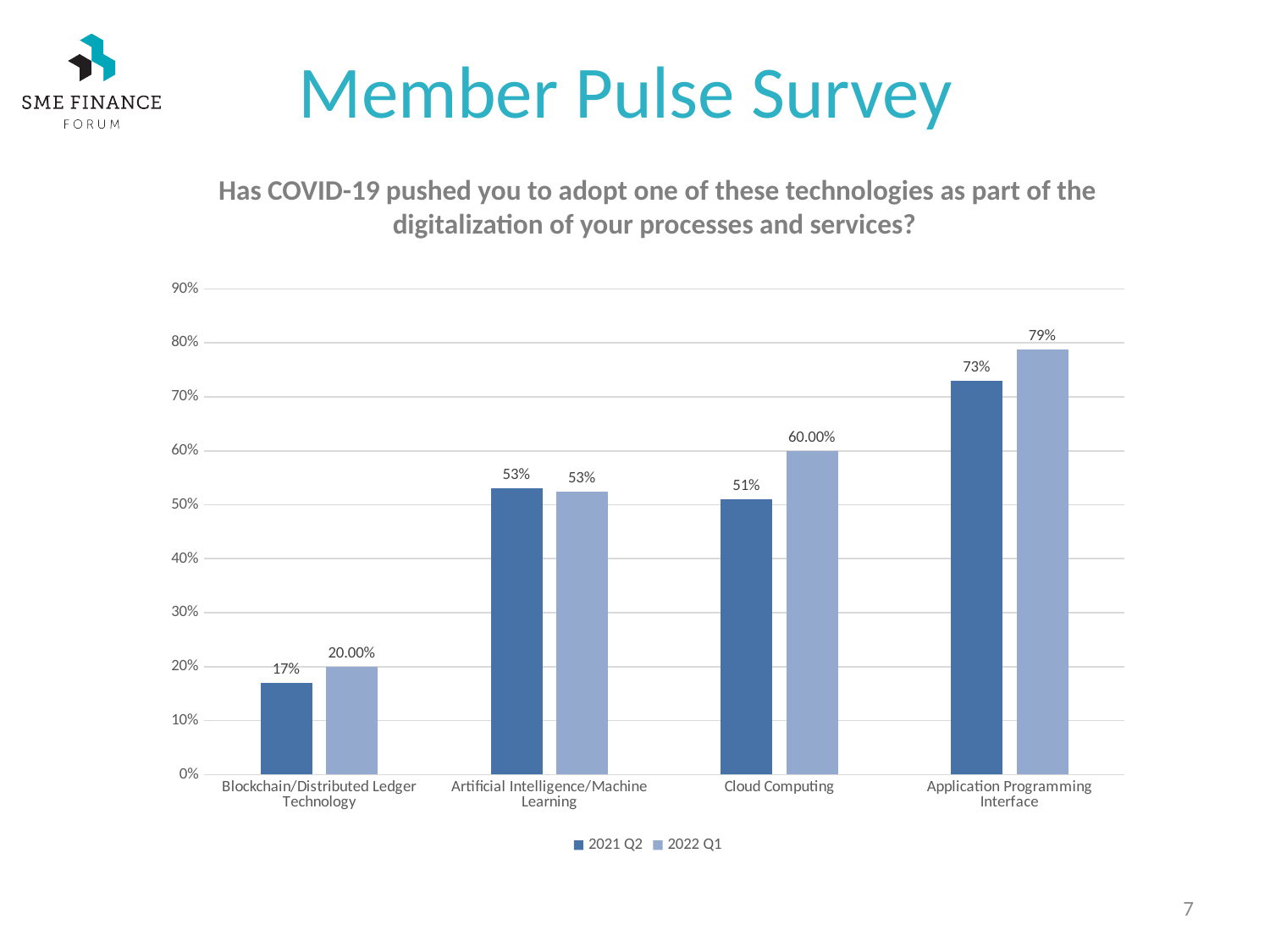
What is the value for Blockchain/Distributed Ledger Technology in the 2022 Q1 series? 20.00% Which is larger for Application Programming Interface: the 2021 Q2 value or the 2022 Q1 value? 2022 Q1 What is the difference between the 2022 Q1 and 2021 Q2 values for Cloud Computing? 9% How many series does the legend list? 2 Which category has the highest value in the 2022 Q1 series? Application Programming Interface What is the value for Cloud Computing in the 2022 Q1 series? 60.00% What kind of chart is shown on the slide? Bar chart What is the value for Application Programming Interface in the 2021 Q2 series? 73% Which category has the lowest value in the 2021 Q2 series? Blockchain/Distributed Ledger Technology What are the two series named in the legend? 2021 Q2 and 2022 Q1 How many categories are shown on the x axis? 4 What is the value for Artificial Intelligence/Machine Learning in the 2021 Q2 series? 53%